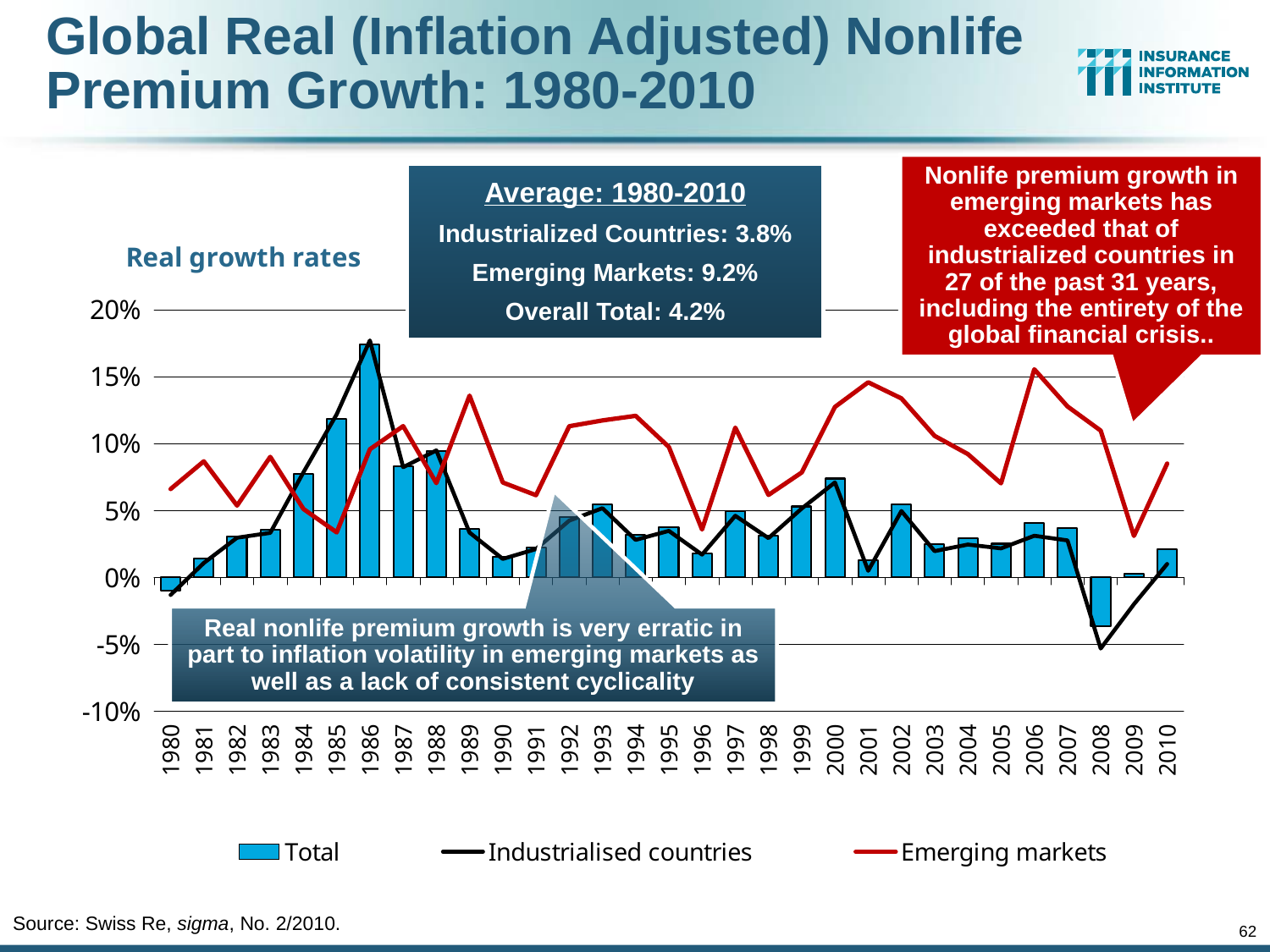
What are the three series named in the chart legend? Total, Industrialised countries, Emerging markets Is the Emerging markets value for 1996 greater or less than 5%? less What kind of chart is shown on the slide? Combined bar and line chart Is the Total value for 1986 greater or less than 15%? greater Is the Emerging markets value for 2000 greater or less than 10%? greater How many years are shown along the x axis of the chart? 31 In which year is the Total bar the lowest? 2008 How many series does the chart legend list? 3 In which year is the Total bar the highest? 1986 In 1986, which is larger: the Industrialised countries value or the Emerging markets value? Industrialised countries Does the Total series rise or fall from 1983 to 1986? rise